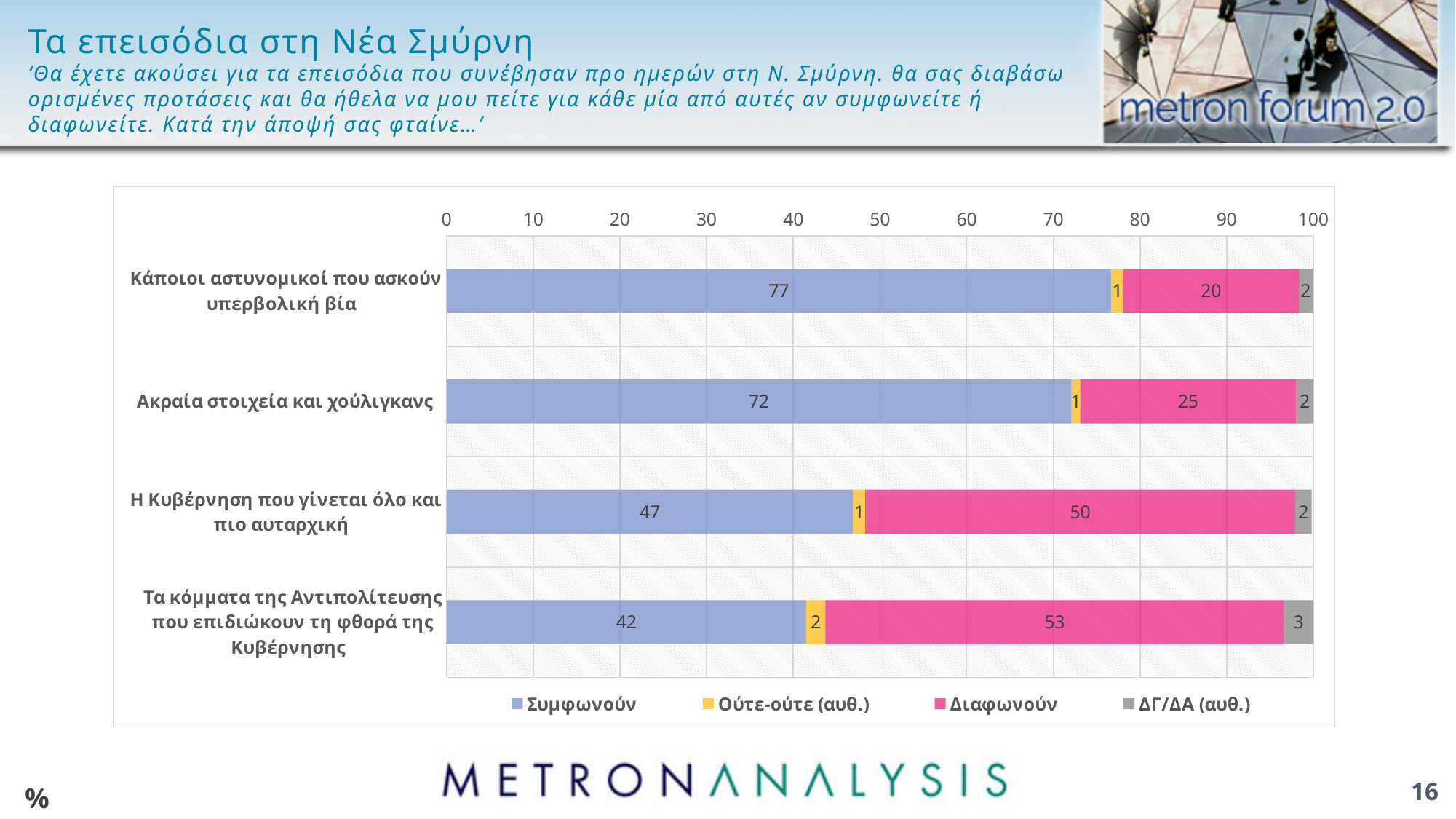
How many categories are shown in the chart? 4 How many series does the legend list? 4 Which category has the highest Συμφωνούν value? Κάποιοι αστυνομικοί που ασκούν υπερβολική βία What is the Συμφωνούν value for 'Κάποιοι αστυνομικοί που ασκούν υπερβολική βία'? 77 For 'Η Κυβέρνηση που γίνεται όλο και πιο αυταρχική', which is larger: Συμφωνούν or Διαφωνούν? Διαφωνούν What is the difference between the Συμφωνούν values for 'Κάποιοι αστυνομικοί που ασκούν υπερβολική βία' and 'Ακραία στοιχεία και χούλιγκανς'? 5 What is the ΔΓ/ΔΑ (αυθ.) value for 'Η Κυβέρνηση που γίνεται όλο και πιο αυταρχική'? 2 What kind of chart is shown on the slide? Stacked bar chart Which category has the lowest Συμφωνούν value? Τα κόμματα της Αντιπολίτευσης που επιδιώκουν τη φθορά της Κυβέρνησης What is the total of the stacked bar for 'Ακραία στοιχεία και χούλιγκανς'? 100 What is the Διαφωνούν value for 'Ακραία στοιχεία και χούλιγκανς'? 25 What is the Διαφωνούν value for 'Τα κόμματα της Αντιπολίτευσης που επιδιώκουν τη φθορά της Κυβέρνησης'? 53